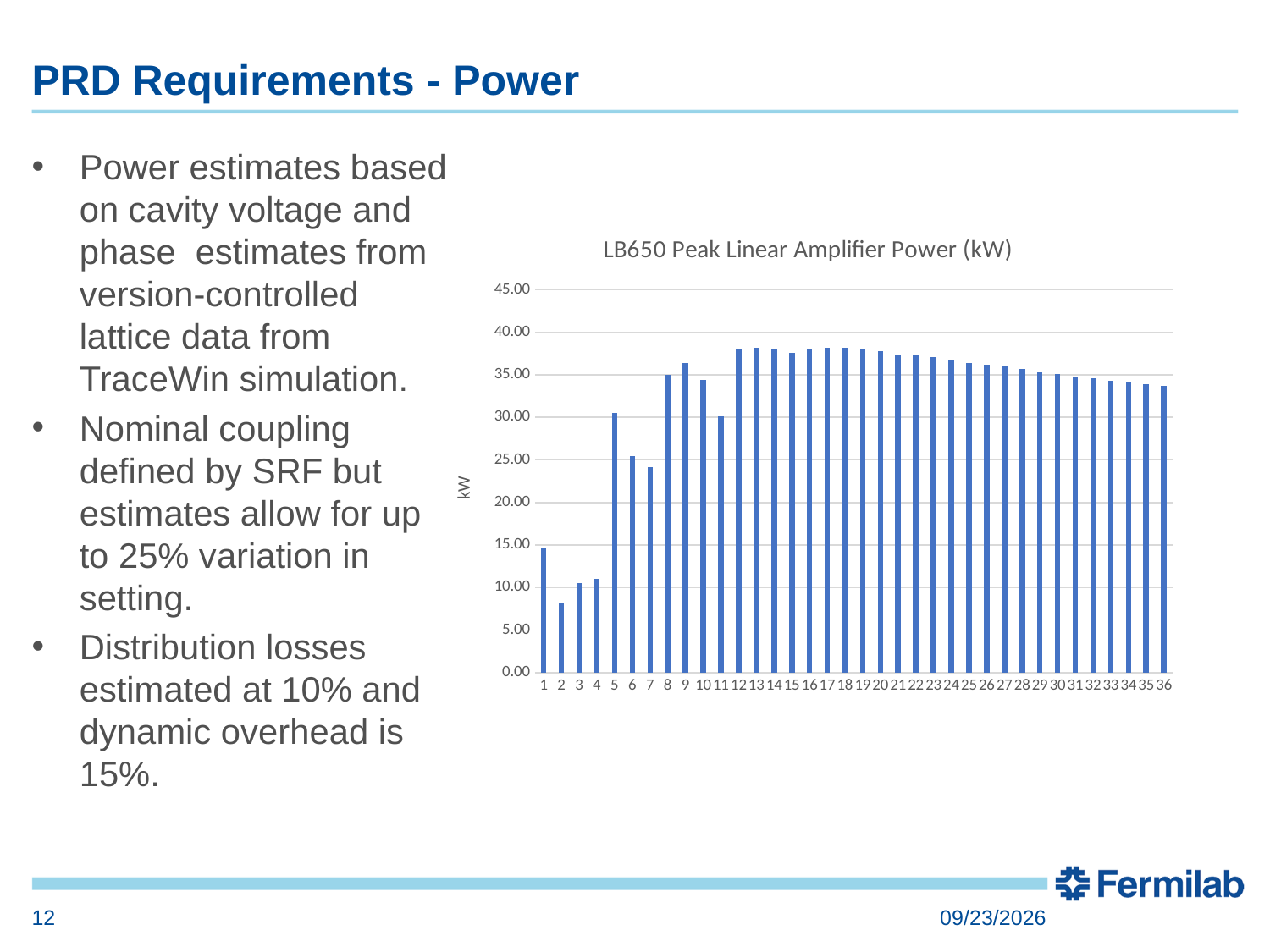
Is the value for category 12 greater or less than 35.00? greater What is the label on the vertical axis of the chart? kW Which category has the lowest value in the chart? 2 What is the title of the chart? LB650 Peak Linear Amplifier Power (kW) Which has the larger value, category 7 or category 8? category 8 Which has the larger value, category 1 or category 4? category 1 What kind of chart is shown on the slide? bar chart Is the value for category 36 greater or less than 35.00? less How many bars (categories) are plotted in the chart? 36 Is the value for category 2 greater or less than 10.00? less Do the values generally rise or fall from category 20 to category 36? fall